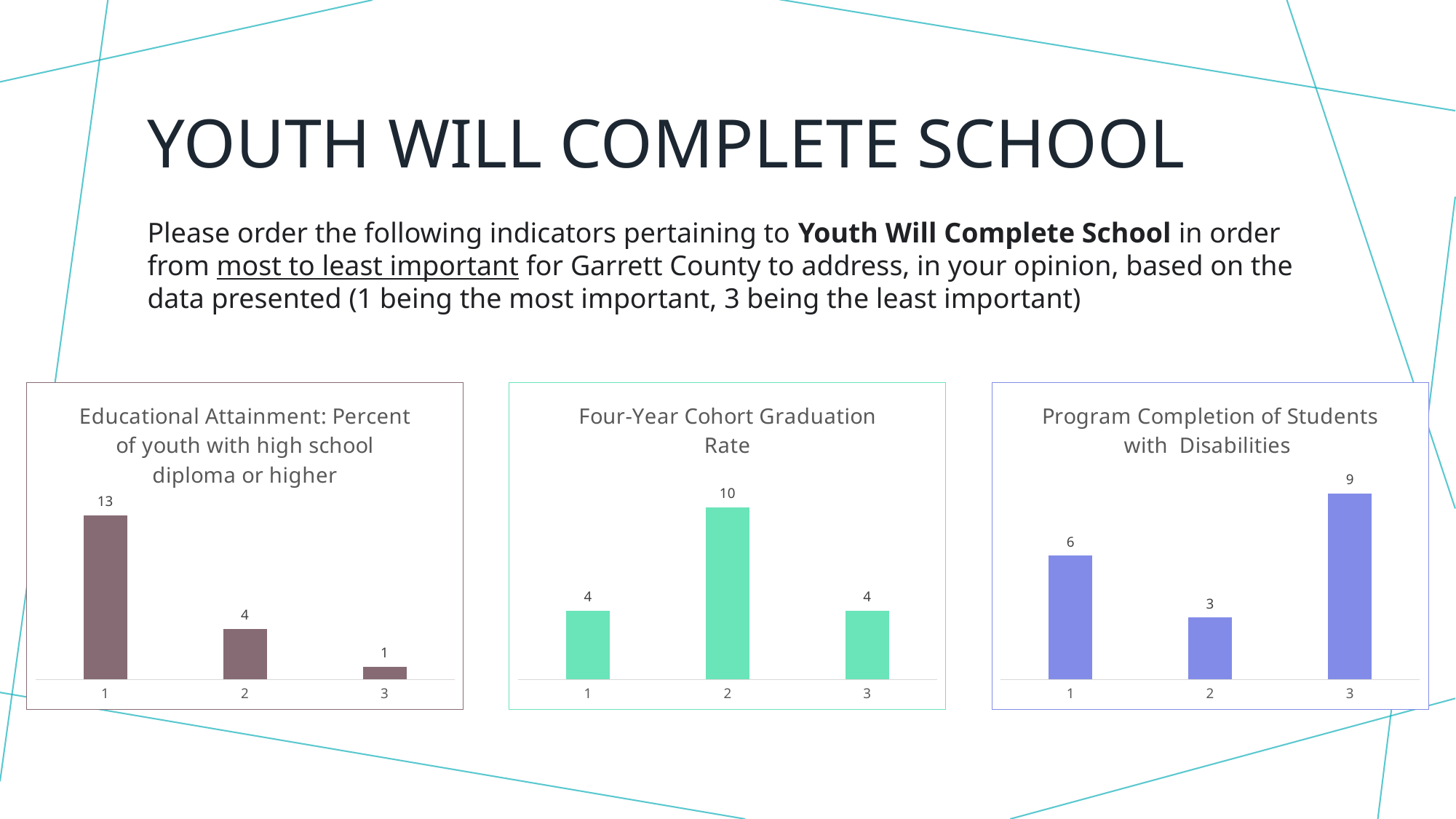
In the 'Program Completion of Students with Disabilities' chart, which category has the highest value? 3 In the 'Four-Year Cohort Graduation Rate' chart, is the value for category 2 larger or smaller than the value for category 1? larger What type of chart is the 'Four-Year Cohort Graduation Rate' chart? bar chart In the 'Educational Attainment: Percent of youth with high school diploma or higher' chart, what is the difference between the values for category 1 and category 2? 9 In the 'Educational Attainment: Percent of youth with high school diploma or higher' chart, do the values rise or fall from category 1 to category 3? fall How many categories are shown in the 'Program Completion of Students with Disabilities' chart? 3 In the 'Program Completion of Students with Disabilities' chart, what is the difference between the values for category 3 and category 2? 6 In the 'Educational Attainment: Percent of youth with high school diploma or higher' chart, which category has the lowest value? 3 In the 'Educational Attainment: Percent of youth with high school diploma or higher' chart, what is the value for category 1? 13 In the 'Four-Year Cohort Graduation Rate' chart, what is the value for category 2? 10 In the 'Program Completion of Students with Disabilities' chart, what is the value for category 3? 9 In the 'Four-Year Cohort Graduation Rate' chart, which category has the highest value? 2